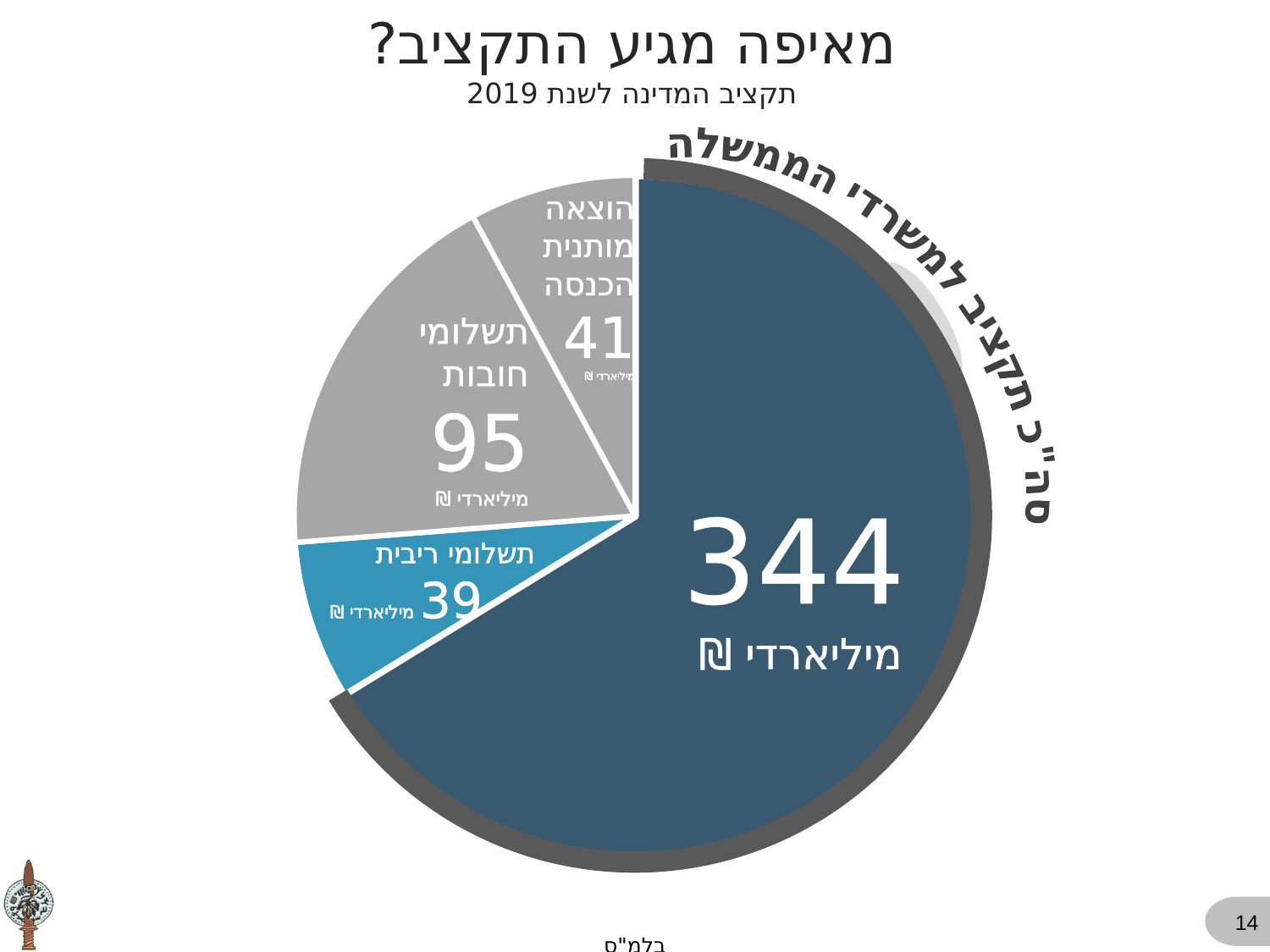
What is the value shown for תשלומי חובות? 95 מיליארדי ₪ Which slice of the pie chart is the largest? סה"כ תקציב למשרדי הממשלה Which year does the chart's subtitle say the state budget is for? 2019 Which is larger, תשלומי חובות or הוצאה מותנית הכנסה? תשלומי חובות What is the value shown for תשלומי ריבית? 39 מיליארדי ₪ How many slices does the pie chart have? 4 What kind of chart is shown on the slide? Pie chart Which slice of the pie chart is the smallest? תשלומי ריבית What is the value shown for הוצאה מותנית הכנסה? 41 מיליארדי ₪ What is the value shown for סה"כ תקציב למשרדי הממשלה? 344 מיליארדי ₪ What is the difference between the values for סה"כ תקציב למשרדי הממשלה and תשלומי חובות? 249 מיליארדי ₪ What is the total of all four slices in the pie chart? 519 מיליארדי ₪